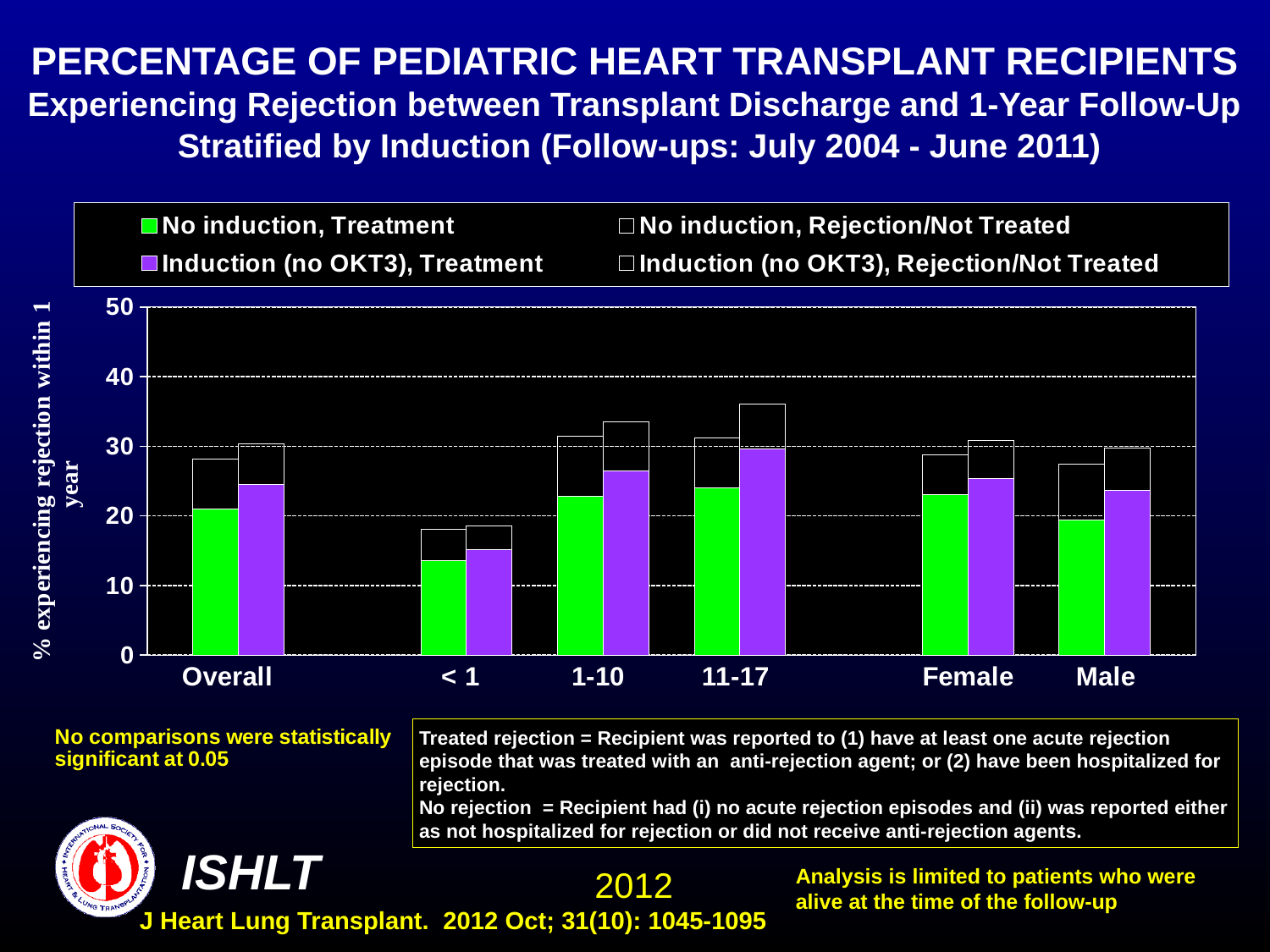
What kind of chart is shown on the slide? bar chart Which category has the lowest value for the No induction, Treatment series? < 1 For the No induction, Treatment series, which is larger: the Female value or the Male value? Female In the Overall category, which is larger: the No induction, Treatment value or the Induction (no OKT3), Treatment value? Induction (no OKT3), Treatment How many series does the legend list? 4 Which category has the highest value for the Induction (no OKT3), Treatment series? 11-17 What is the label on the y axis of the chart? % experiencing rejection within 1 year Is the value for No induction, Treatment in the Overall category greater or less than 30? less Is the value for No induction, Treatment in the < 1 category greater or less than 20? less Which category has the lowest value for the Induction (no OKT3), Treatment series? < 1 How many categories are shown along the x axis? 6 Is the value for Induction (no OKT3), Treatment in the Overall category greater or less than 20? greater